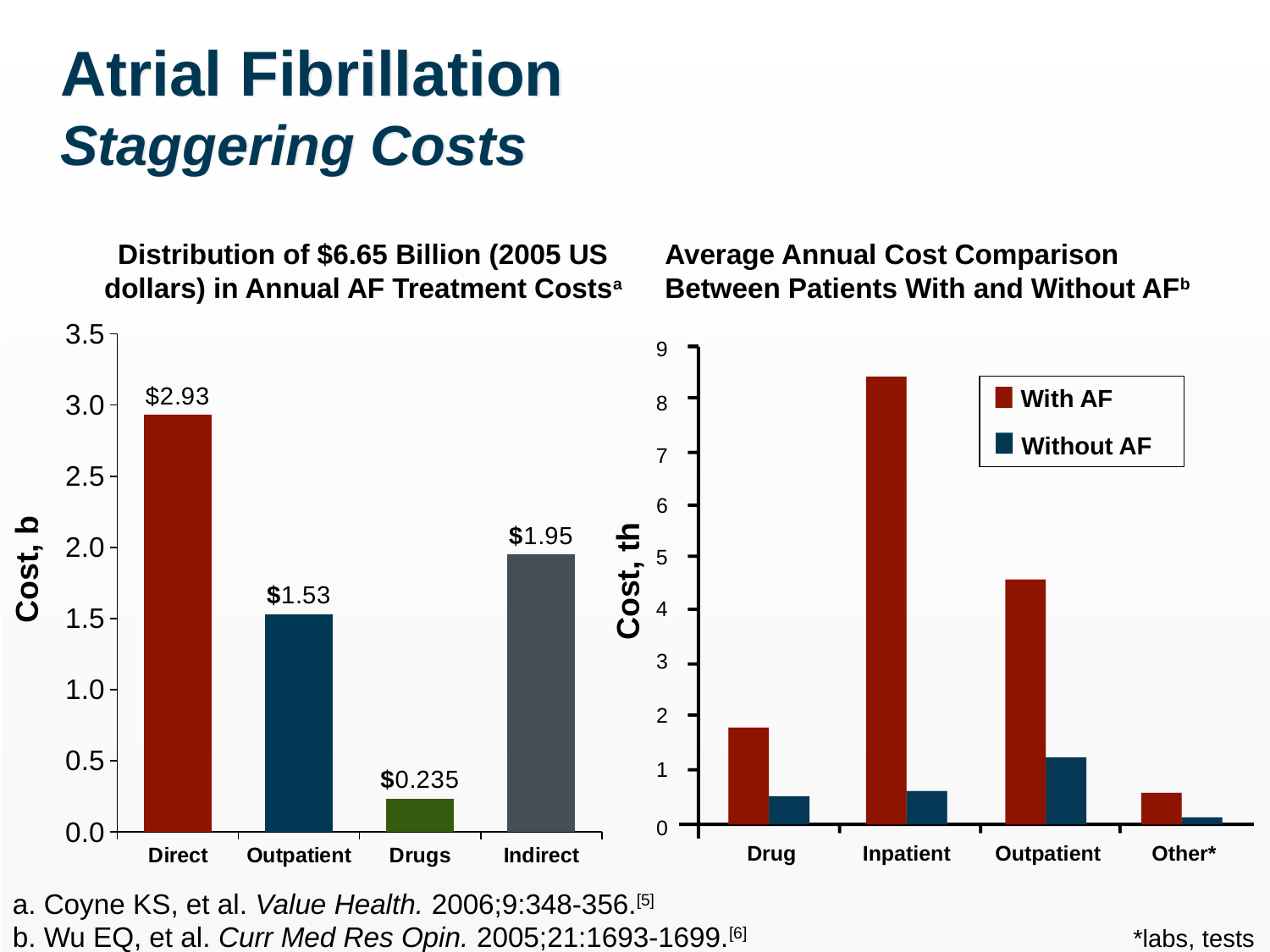
In the left chart, Distribution of $6.65 Billion in Annual AF Treatment Costs, which category has the highest cost? Direct In the right chart, Average Annual Cost Comparison Between Patients With and Without AF, is the Without AF value for Outpatient greater or less than 2? less In the left chart, Distribution of $6.65 Billion in Annual AF Treatment Costs, what is the value for Direct? $2.93 In the right chart, Average Annual Cost Comparison Between Patients With and Without AF, how many series does the legend list? 2 In the left chart, Distribution of $6.65 Billion in Annual AF Treatment Costs, which category has the lowest cost? Drugs In the left chart, Distribution of $6.65 Billion in Annual AF Treatment Costs, what is the value for Drugs? $0.235 In the right chart, Average Annual Cost Comparison Between Patients With and Without AF, is the With AF value for Inpatient greater or less than 8? greater In the right chart, Average Annual Cost Comparison Between Patients With and Without AF, which category has the highest With AF cost? Inpatient In the right chart, Average Annual Cost Comparison Between Patients With and Without AF, which is larger for Outpatient: the With AF value or the Without AF value? With AF In the left chart, Distribution of $6.65 Billion in Annual AF Treatment Costs, what is the difference between the Direct and Indirect values? $0.98 In the left chart, Distribution of $6.65 Billion in Annual AF Treatment Costs, how many categories are shown on the x axis? 4 What kind of chart is the right chart, Average Annual Cost Comparison Between Patients With and Without AF? Bar chart